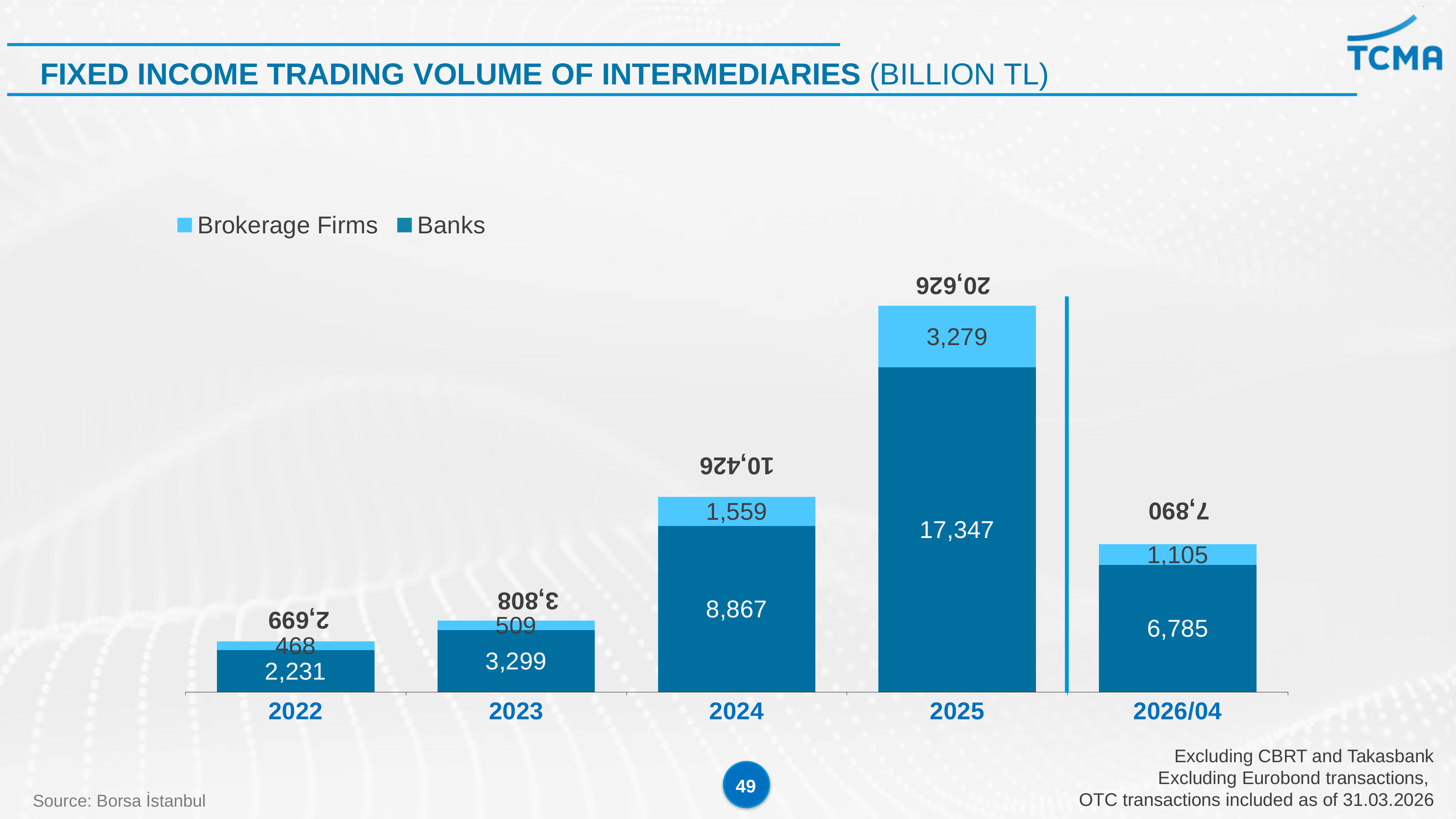
How many series does the legend list? 2 What kind of chart is shown on the slide? Stacked bar chart What is the Banks value for 2026/04? 6,785 How many categories are shown on the x axis? 5 What is the Banks value for 2025? 17,347 Which is larger, the Brokerage Firms value for 2025 or for 2026/04? 2025 What is the total of the stacked bar for 2025? 20,626 Which year has the highest Banks value? 2025 What is the difference between the Banks values for 2024 and 2023? 5,568 What is the Brokerage Firms value for 2024? 1,559 What is the Brokerage Firms value for 2022? 468 Which year has the lowest Brokerage Firms value? 2022